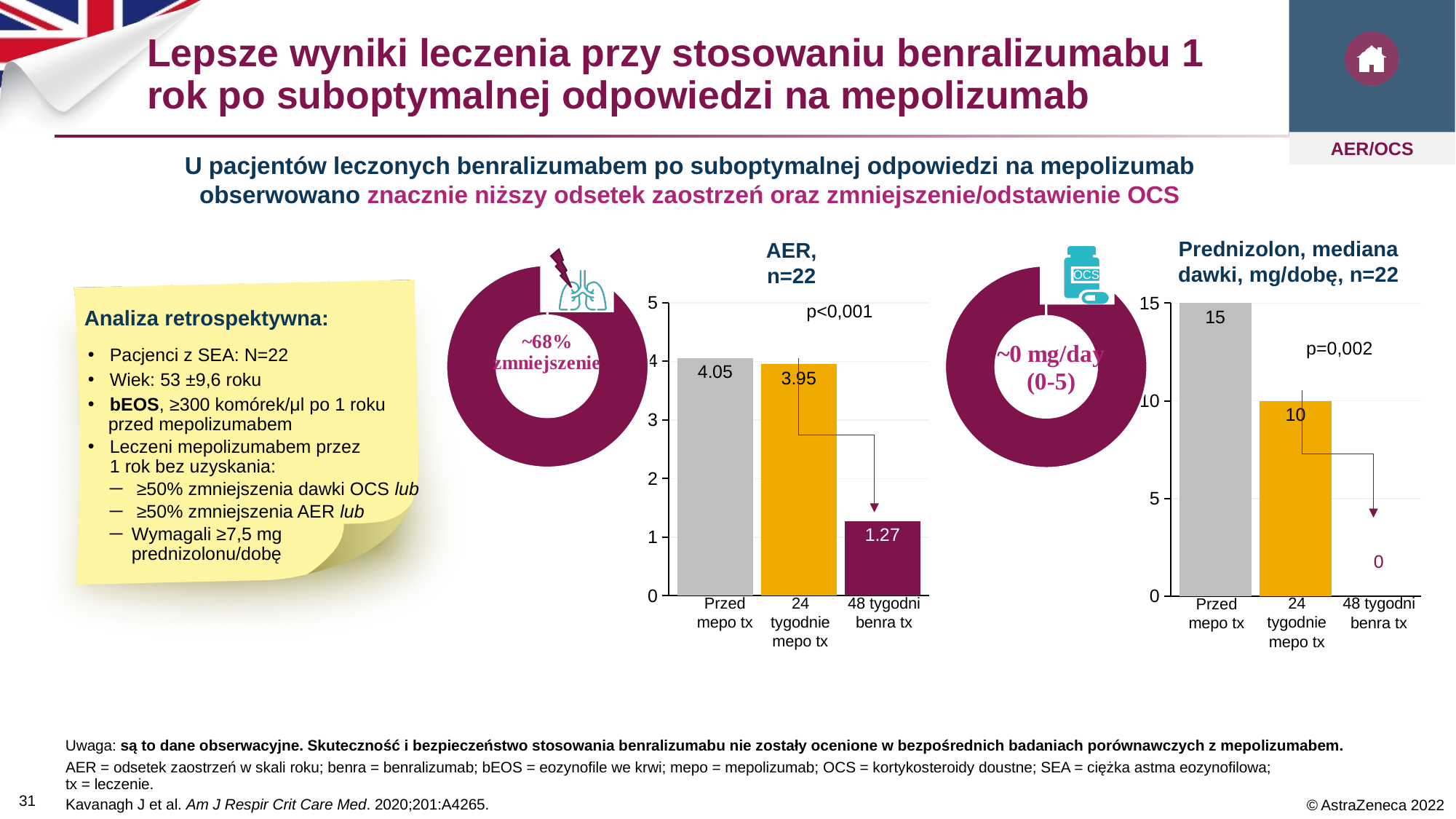
In the 'AER, n=22' chart, how many bars are plotted? 3 In the 'AER, n=22' chart, is the value for '24 tygodnie mepo tx' greater or less than 3? greater In the 'AER, n=22' chart, what is the value for 'Przed mepo tx'? 4.05 In the 'AER, n=22' chart, which category has the lowest value? 48 tygodni benra tx In the 'Prednizolon, mediana dawki, mg/dobę, n=22' chart, what is the difference between 'Przed mepo tx' and '24 tygodnie mepo tx'? 5 In the 'Prednizolon, mediana dawki, mg/dobę, n=22' chart, do the values rise or fall from left to right? fall In the 'Prednizolon, mediana dawki, mg/dobę, n=22' chart, which category has the highest value? Przed mepo tx What kind of chart is the 'AER, n=22' chart? bar chart In the 'AER, n=22' chart, what is the value for '48 tygodni benra tx'? 1.27 In the 'Prednizolon, mediana dawki, mg/dobę, n=22' chart, what is the value for '24 tygodnie mepo tx'? 10 In the 'Prednizolon, mediana dawki, mg/dobę, n=22' chart, what is the value for 'Przed mepo tx'? 15 In the 'AER, n=22' chart, what is the difference between '24 tygodnie mepo tx' and '48 tygodni benra tx'? 2.68